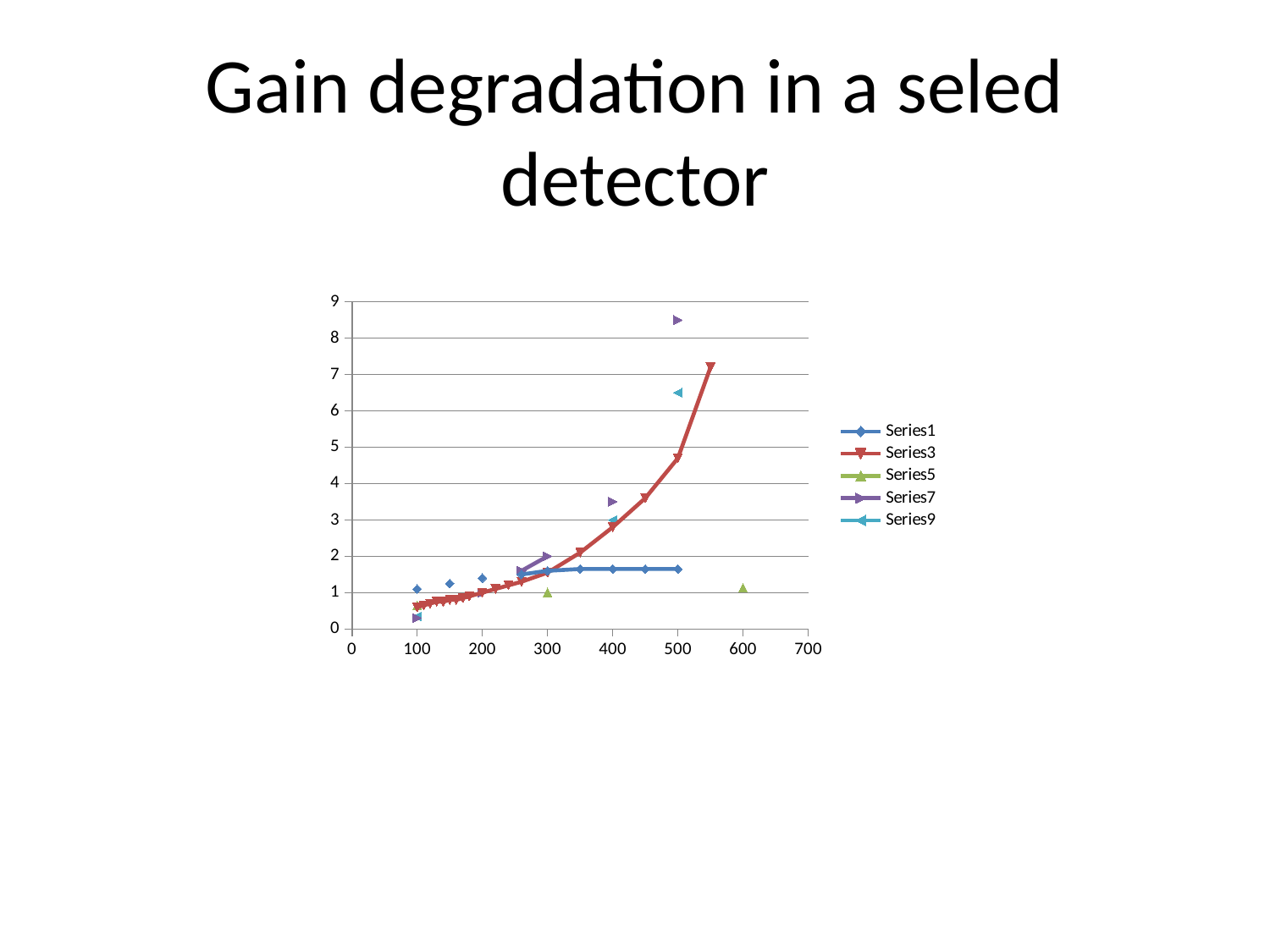
Which series is drawn in red? Series3 Do the values of Series3 rise or fall as x increases? rise What kind of chart is shown on the slide? scatter chart Is the value of Series3 at x = 100 greater or less than 1? less At x = 500, which is larger: the value of Series3 or the value of Series1? Series3 How many series does the legend list? 5 Is the value of Series7 at x = 500 greater or less than 8? greater Is the value of Series9 at x = 500 greater or less than 6? greater Which series reaches the highest value on the chart? Series7 What is the title of the chart? Gain degradation in a seled detector